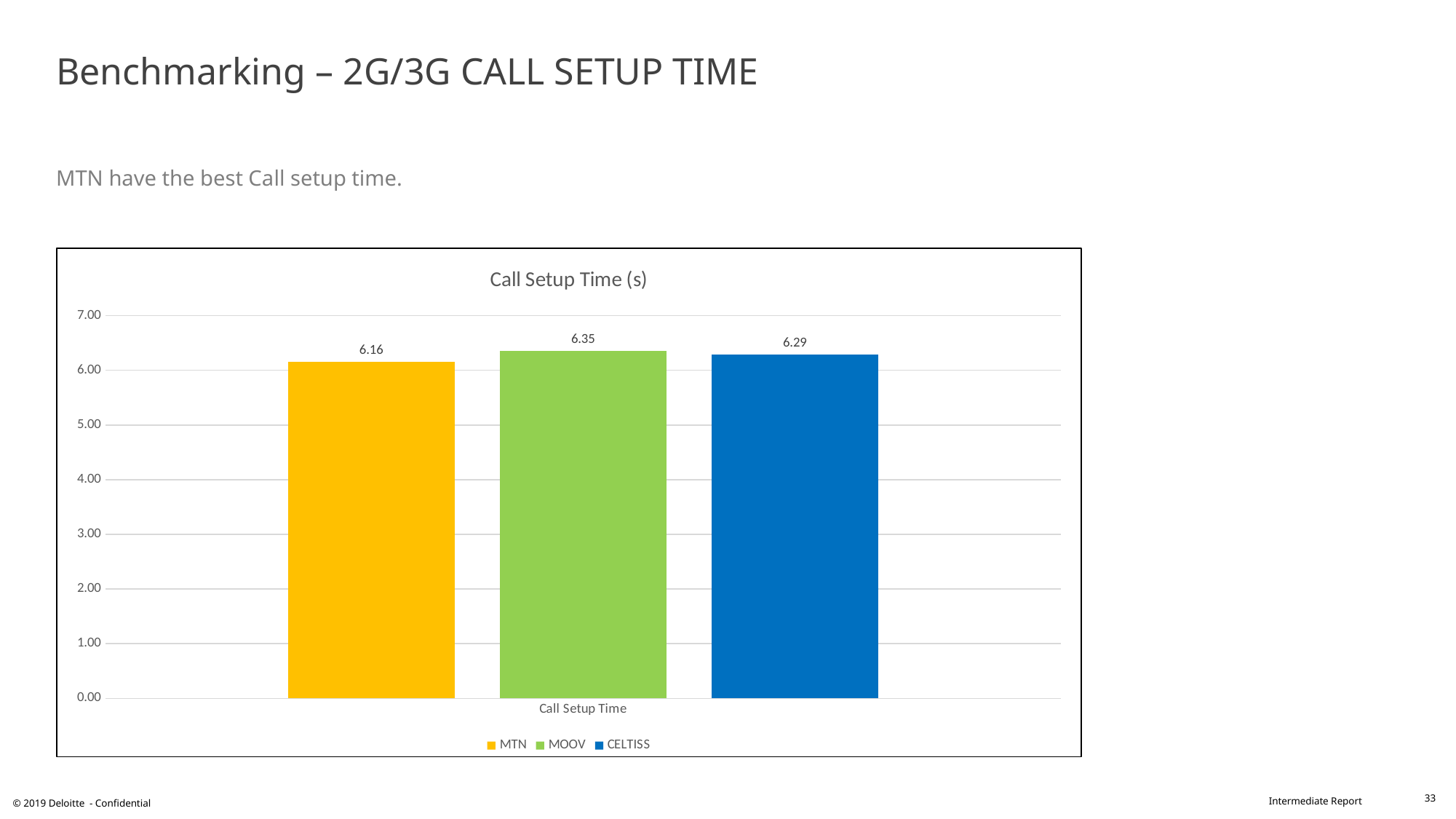
Which operator has the highest call setup time? MOOV What is the call setup time for MOOV? 6.35 What is the call setup time for MTN? 6.16 What is the difference between the call setup times of MOOV and MTN? 0.19 Which operator has the lowest call setup time? MTN What is the difference between the call setup times of CELTISS and MTN? 0.13 What is the call setup time for CELTISS? 6.29 What kind of chart is shown on the slide? Bar chart How many series does the legend list? 3 Which has a larger call setup time, MOOV or CELTISS? MOOV What is the title of the chart? Call Setup Time (s) Is the call setup time for MTN greater or less than 6.00? greater